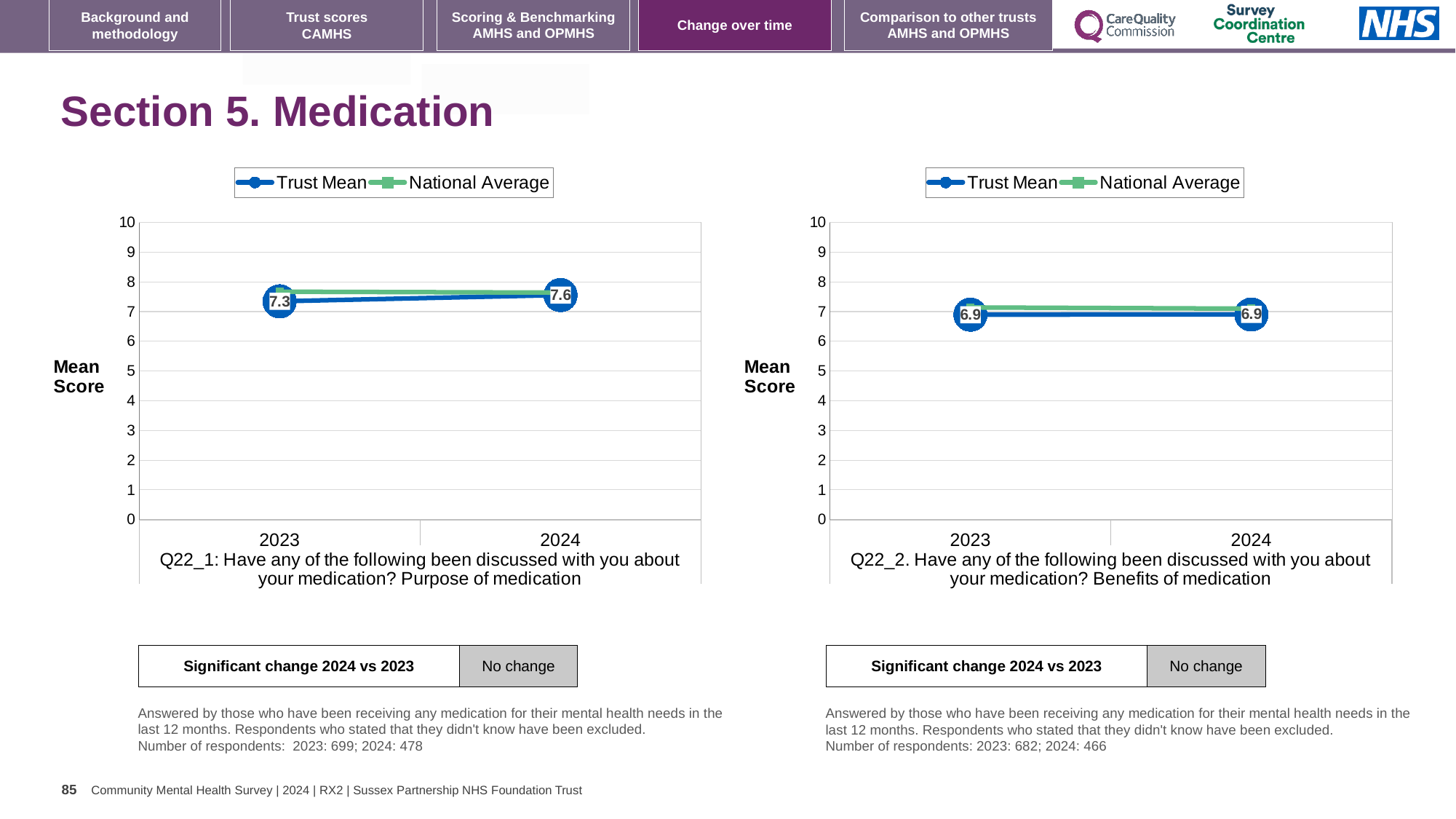
In the Q22_1 chart (Purpose of medication), is the Trust Mean higher in 2023 or 2024? 2024 In the Q22_2 chart (Benefits of medication), is the Trust Mean for 2023 greater or less than 8? less In the Q22_1 chart (Purpose of medication), is the National Average for 2024 greater or less than 7? greater In the Q22_2 chart (Benefits of medication), what is the Trust Mean for 2023? 6.9 How many series does the legend of the Q22_1 chart (Purpose of medication) list? 2 In the Q22_2 chart (Benefits of medication), what is the Trust Mean for 2024? 6.9 What kind of chart is the Q22_2 chart (Benefits of medication)? line chart How many years are shown on the x axis of the Q22_2 chart (Benefits of medication)? 2 In the Q22_1 chart (Purpose of medication), what is the Trust Mean for 2023? 7.3 In the Q22_1 chart (Purpose of medication), what is the Trust Mean for 2024? 7.6 In the Q22_1 chart (Purpose of medication), by how much did the Trust Mean change from 2023 to 2024? 0.3 In the Q22_1 chart (Purpose of medication), does the Trust Mean rise or fall from 2023 to 2024? rise